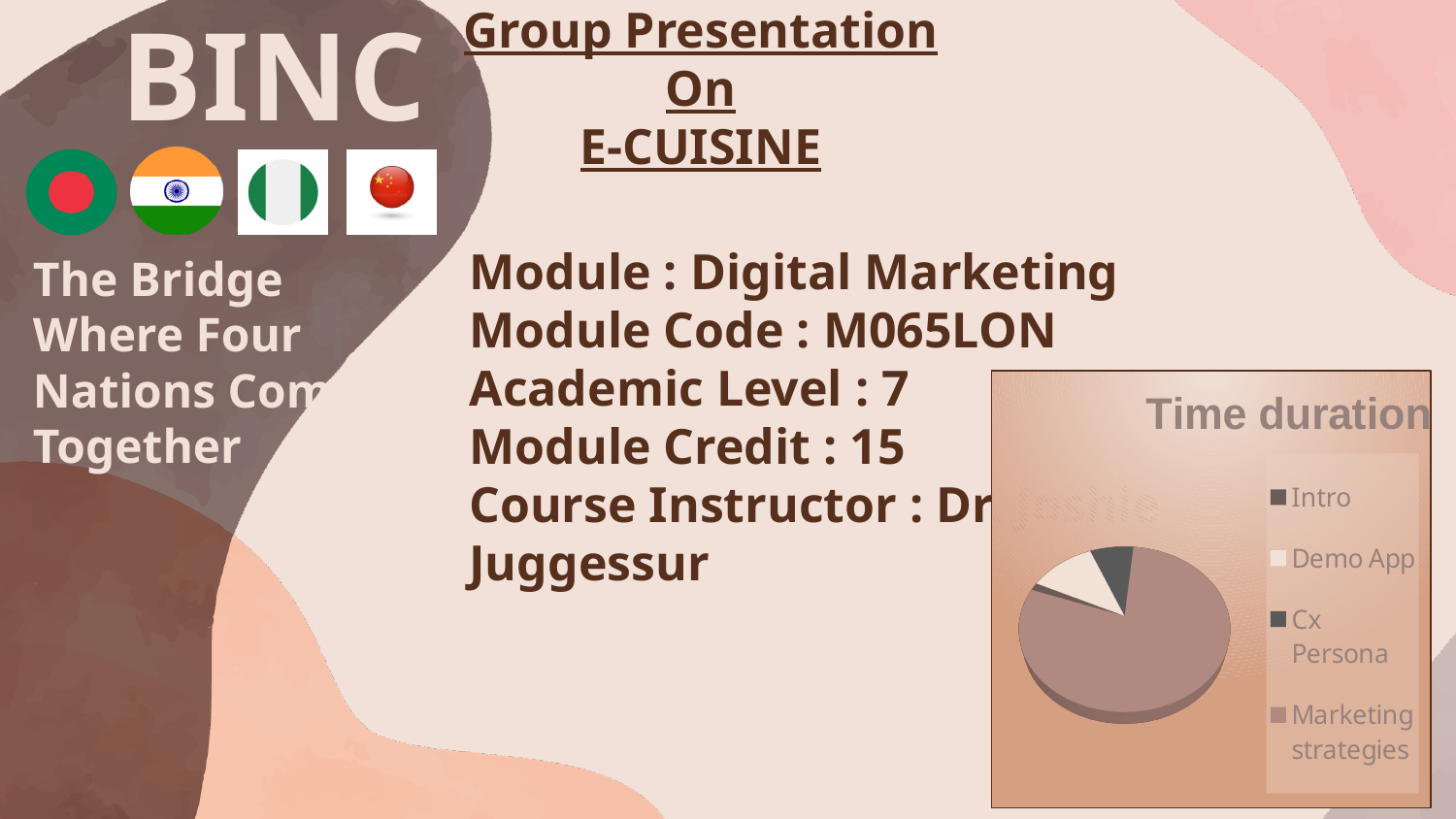
Is the share of the pie for Marketing strategies greater or less than 50%? greater Which is larger in the pie chart, the slice for Cx Persona or the slice for Marketing strategies? Marketing strategies Which legend entry is listed first in the pie chart's legend? Intro Which is larger in the pie chart, the slice for Marketing strategies or the slice for Demo App? Marketing strategies Which category takes up the largest share of the pie chart? Marketing strategies What is the title of the chart? Time duration Is the share of the pie for Demo App greater or less than 25%? less How many categories does the legend of the pie chart list? 4 What kind of chart is shown on the slide? pie chart